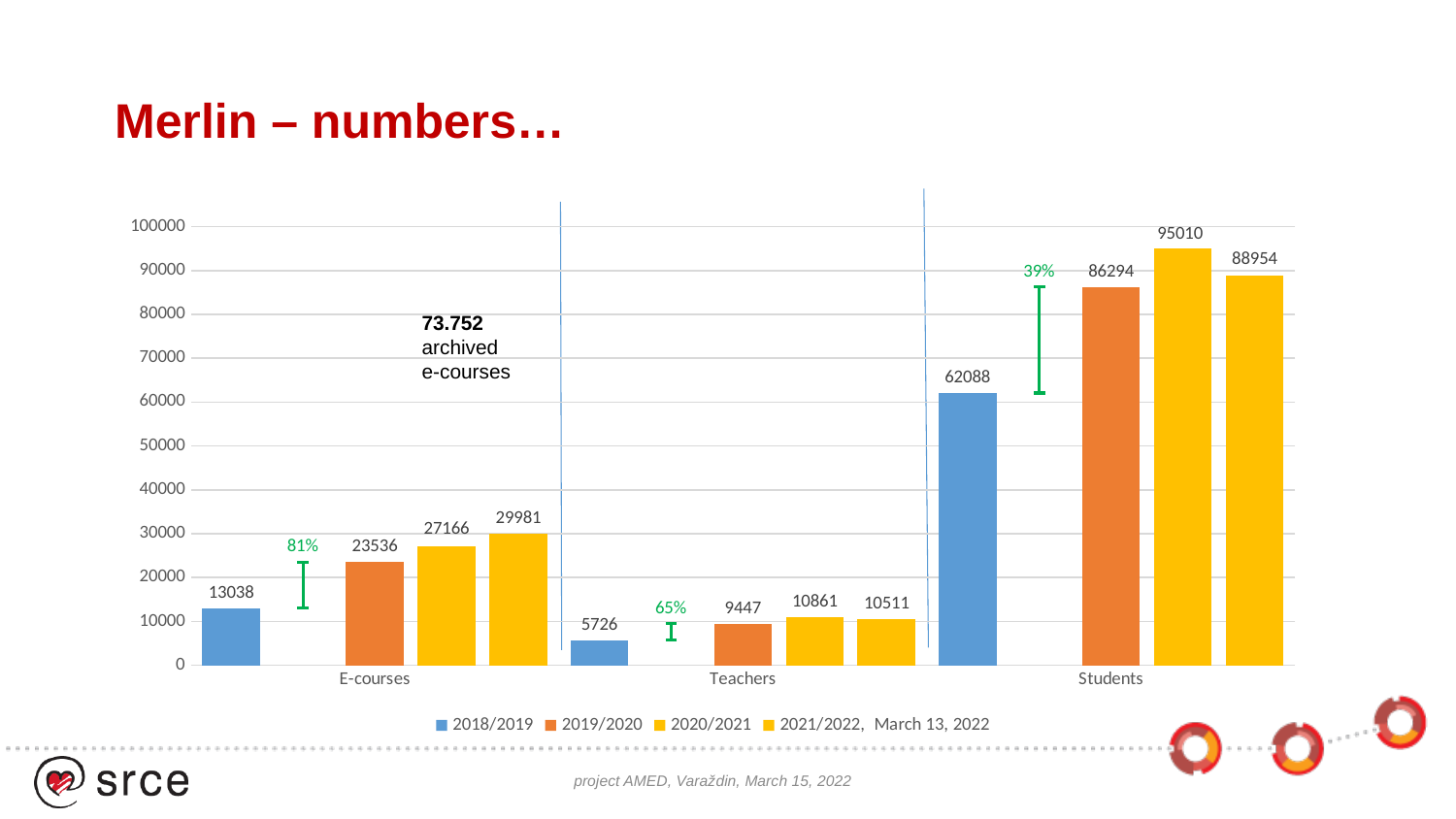
What is the value for Students in 2019/2020? 86294 What percentage increase is annotated in green above the Students group? 39% Do the E-courses values rise or fall from 2018/2019 to 2021/2022? rise How many categories are shown on the x axis? 3 Which is larger for Teachers: the 2020/2021 value or the 2021/2022 value? 2020/2021 How many series does the legend list? 4 Which category has the highest value in 2020/2021? Students Which series has the lowest value for Teachers? 2018/2019 What is the value for Teachers in 2020/2021? 10861 What is the difference between the Students values for 2020/2021 and 2021/2022? 6056 What is the value for E-courses in 2018/2019? 13038 What kind of chart is shown on the slide? bar chart